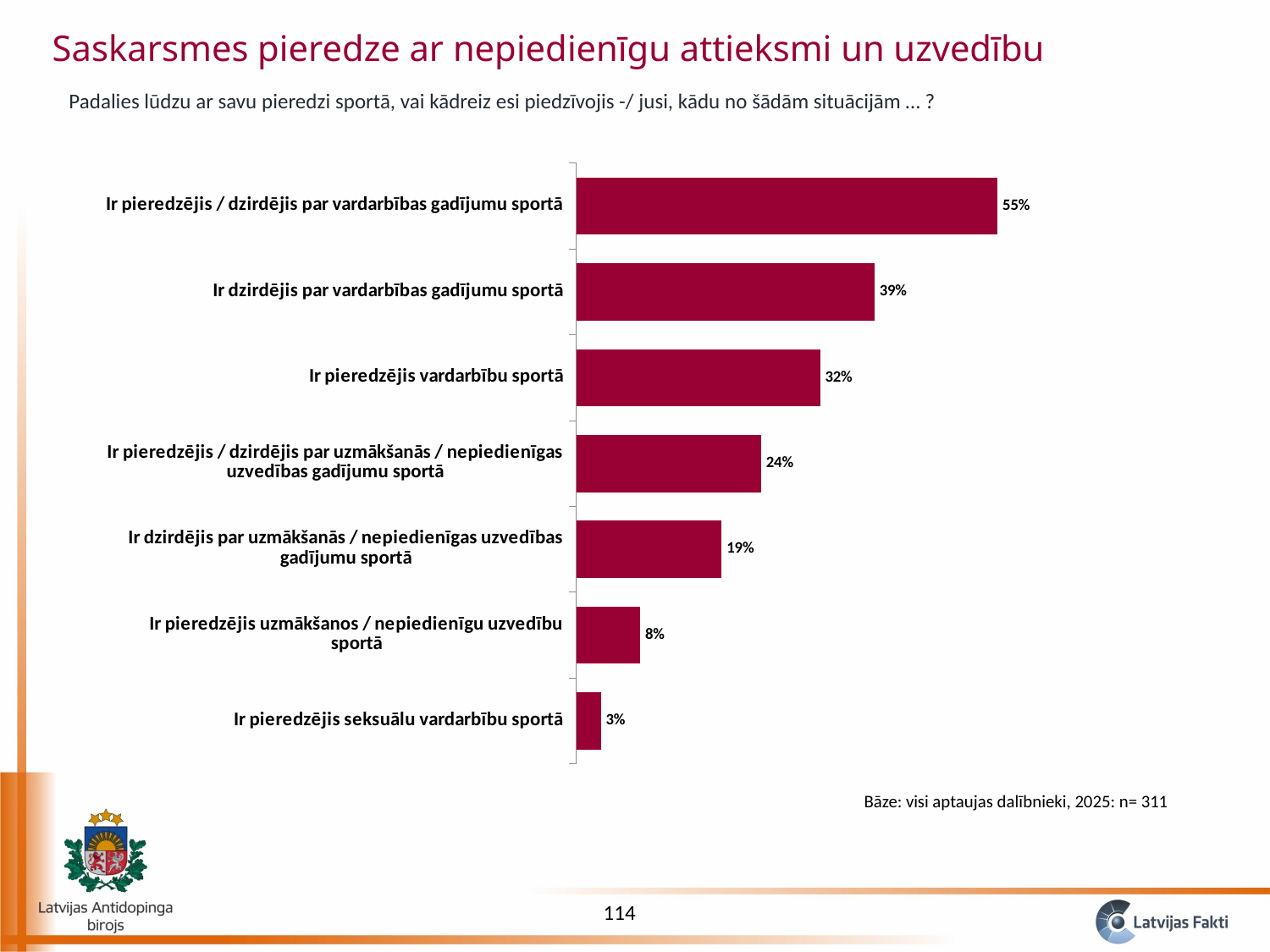
What is the value for "Ir dzirdējis par uzmākšanās / nepiedienīgas uzvedības gadījumu sportā"? 19% How many categories are shown in the chart? 7 What is the difference between "Ir dzirdējis par vardarbības gadījumu sportā" and "Ir pieredzējis vardarbību sportā"? 7% What is the title of the slide? Saskarsmes pieredze ar nepiedienīgu attieksmi un uzvedību Which category has the highest value? Ir pieredzējis / dzirdējis par vardarbības gadījumu sportā What is the value for "Ir pieredzējis / dzirdējis par vardarbības gadījumu sportā"? 55% What is the value for "Ir pieredzējis seksuālu vardarbību sportā"? 3% What is the value for "Ir pieredzējis vardarbību sportā"? 32% Which is larger: "Ir dzirdējis par vardarbības gadījumu sportā" or "Ir pieredzējis / dzirdējis par uzmākšanās / nepiedienīgas uzvedības gadījumu sportā"? Ir dzirdējis par vardarbības gadījumu sportā Which category has the lowest value? Ir pieredzējis seksuālu vardarbību sportā What is the difference between "Ir pieredzējis / dzirdējis par uzmākšanās / nepiedienīgas uzvedības gadījumu sportā" and "Ir pieredzējis uzmākšanos / nepiedienīgu uzvedību sportā"? 16% What kind of chart is shown on the slide? Bar chart